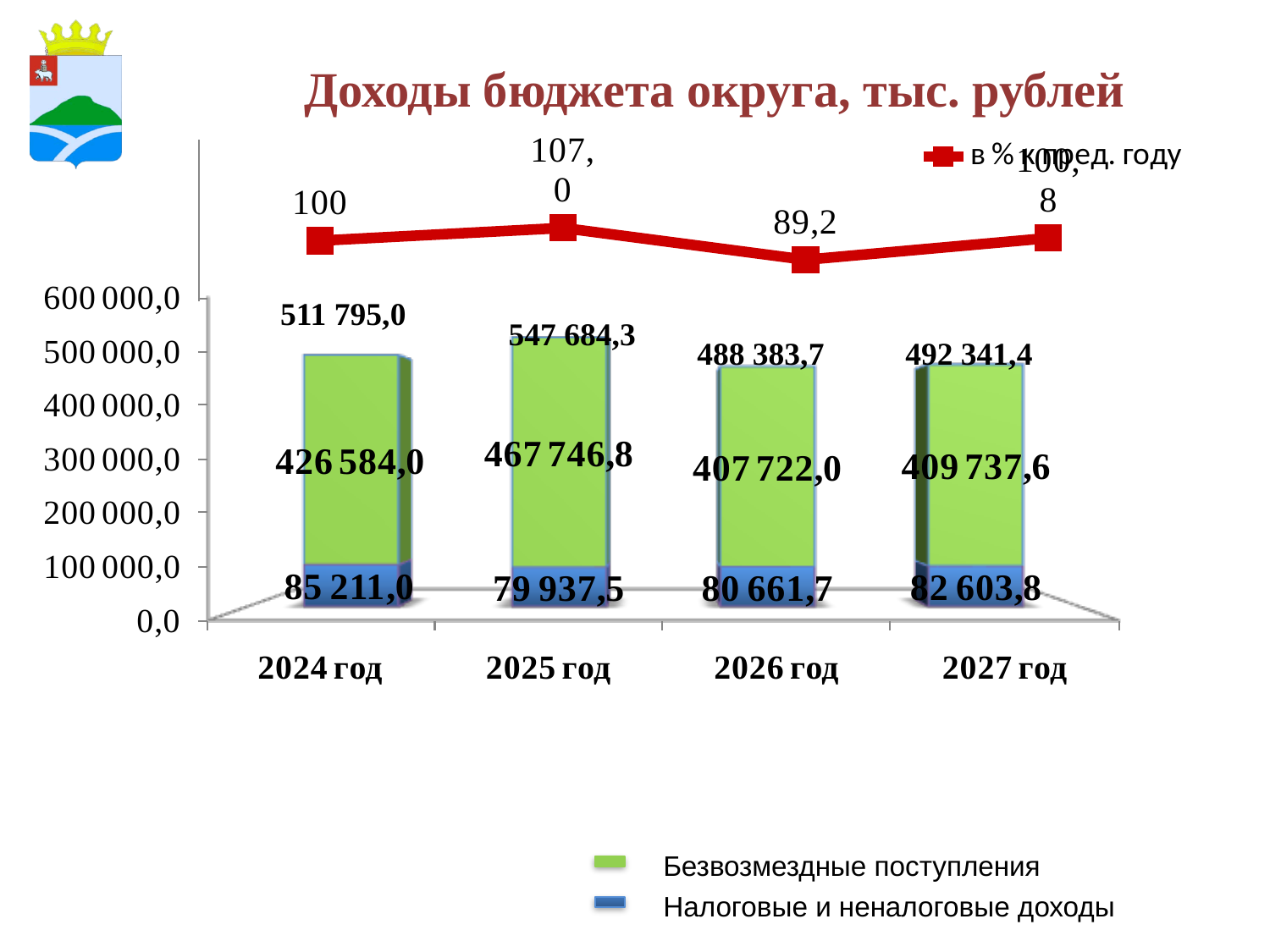
What is the value of Налоговые и неналоговые доходы for 2024 год? 85 211,0 Which is larger: Налоговые и неналоговые доходы in 2024 год or in 2025 год? 2024 год What is the difference between Безвозмездные поступления in 2025 год and 2026 год? 60 024,8 What is the value of the line 'в % к пред. году' for 2026 год? 89,2 What is the value of Налоговые и неналоговые доходы for 2027 год? 82 603,8 How many years are shown on the x axis? 4 What is the value of Безвозмездные поступления for 2025 год? 467 746,8 What is the total budget income shown for 2025 год? 547 684,3 What is the title of the chart? Доходы бюджета округа, тыс. рублей What kind of chart is shown on the slide? Stacked bar chart with a line Which year has the lowest value of Безвозмездные поступления? 2026 год Which year has the highest total budget income? 2025 год